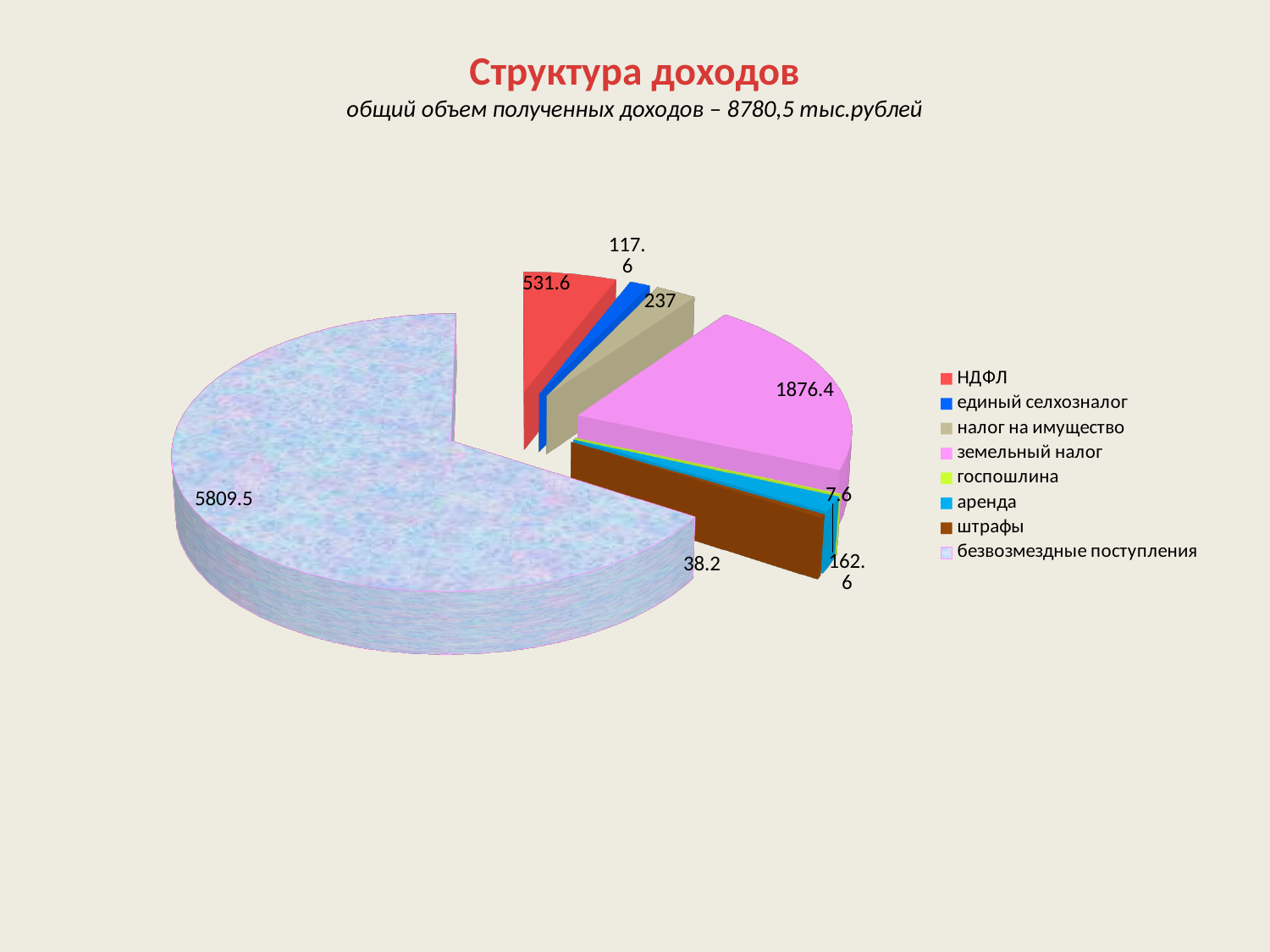
What is the value shown for аренда? 162.6 What is the title of the chart? Структура доходов What is the value shown for налог на имущество? 237 Which category has the smallest slice of the pie? госпошлина What is the difference between the values for земельный налог and НДФЛ? 1344.8 How many categories does the legend list? 8 Which category has the largest slice of the pie? безвозмездные поступления What kind of chart is shown on the slide? pie chart What is the value shown for безвозмездные поступления? 5809.5 Which is larger, the value for штрафы or the value for аренда? аренда What is the value shown for НДФЛ? 531.6 What is the value shown for земельный налог? 1876.4